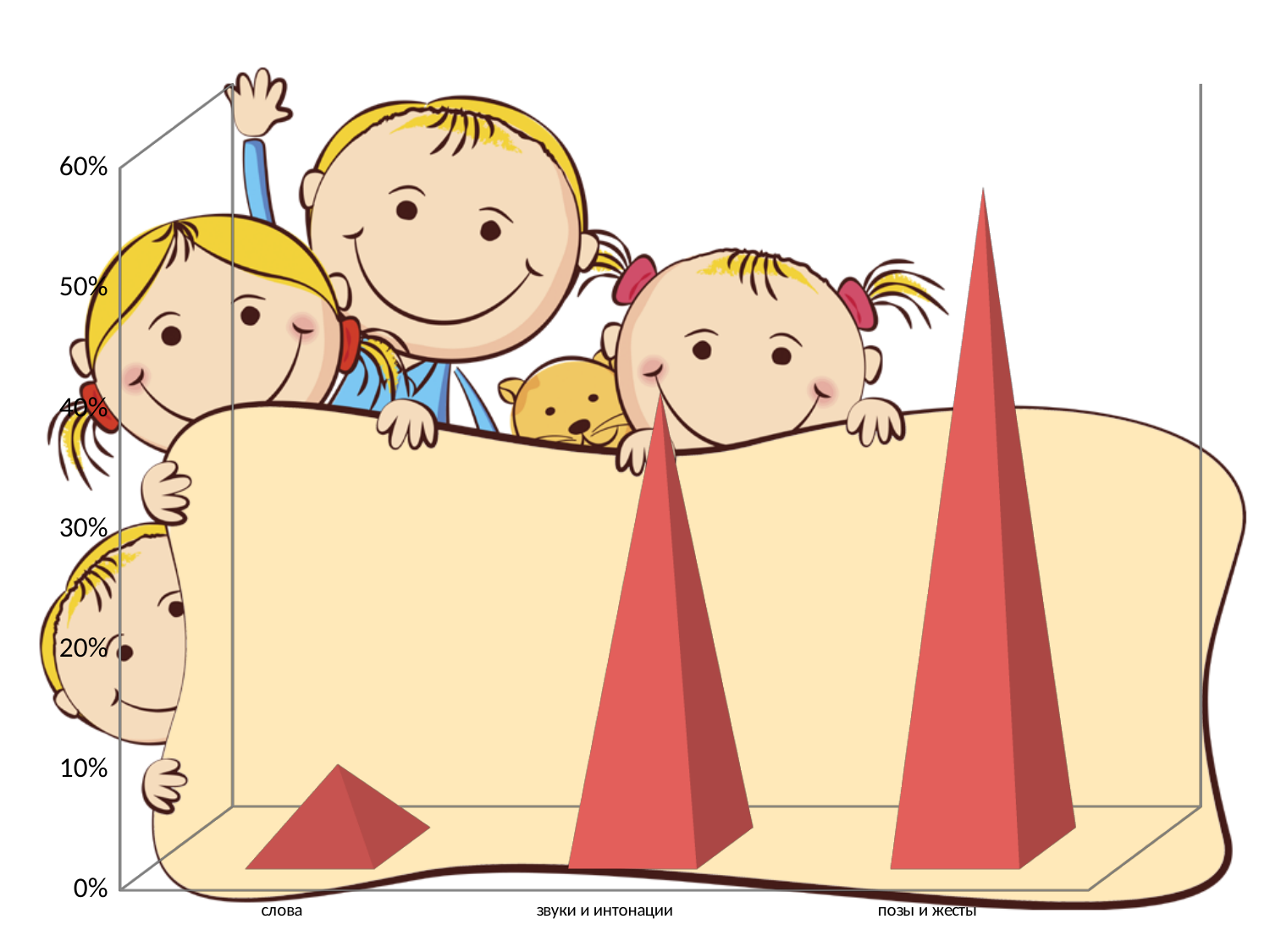
Which is larger, the value for позы и жесты or the value for звуки и интонации? позы и жесты Which category has the highest value in the chart? позы и жесты Which category has the lowest value in the chart? слова Which is larger, the value for звуки и интонации or the value for слова? звуки и интонации How many categories are shown on the x axis of the chart? 3 Do the values rise or fall from left to right along the x axis? rise Is the value for звуки и интонации greater or less than 50%? less Is the value for слова greater or less than 20%? less Is the value for позы и жесты greater or less than 40%? greater What is the highest value shown on the vertical axis of the chart? 60% What kind of chart is shown on the slide? bar chart